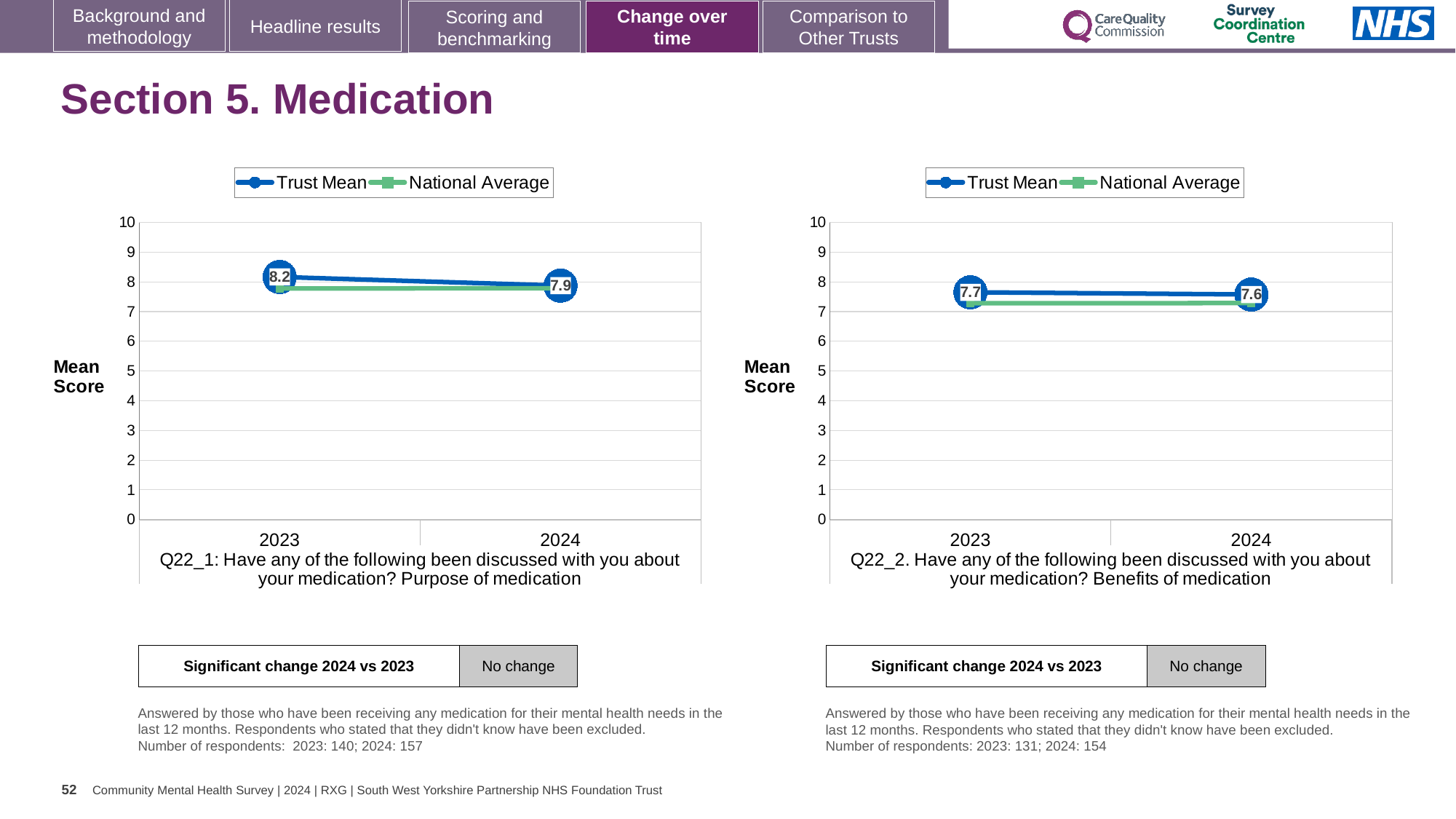
In the left chart (Q22_1: Purpose of medication), what is the Trust Mean for 2023? 8.2 In the left chart (Q22_1), which year has the higher Trust Mean? 2023 What kind of chart is the left chart (Q22_1)? line chart How many series does the legend of the right chart (Q22_2) list? 2 In the right chart (Q22_2: Benefits of medication), what is the Trust Mean for 2024? 7.6 In the left chart (Q22_1), by how much did the Trust Mean change from 2023 to 2024? 0.3 In the right chart (Q22_2), is the National Average for 2023 greater or less than 7? greater In the right chart (Q22_2: Benefits of medication), what is the Trust Mean for 2023? 7.7 In the left chart (Q22_1: Purpose of medication), what is the Trust Mean for 2024? 7.9 In the left chart (Q22_1), does the Trust Mean rise or fall from 2023 to 2024? fall How many years are shown on the x axis of the left chart (Q22_1)? 2 In the right chart (Q22_2), what is the difference between the Trust Mean in 2023 and 2024? 0.1